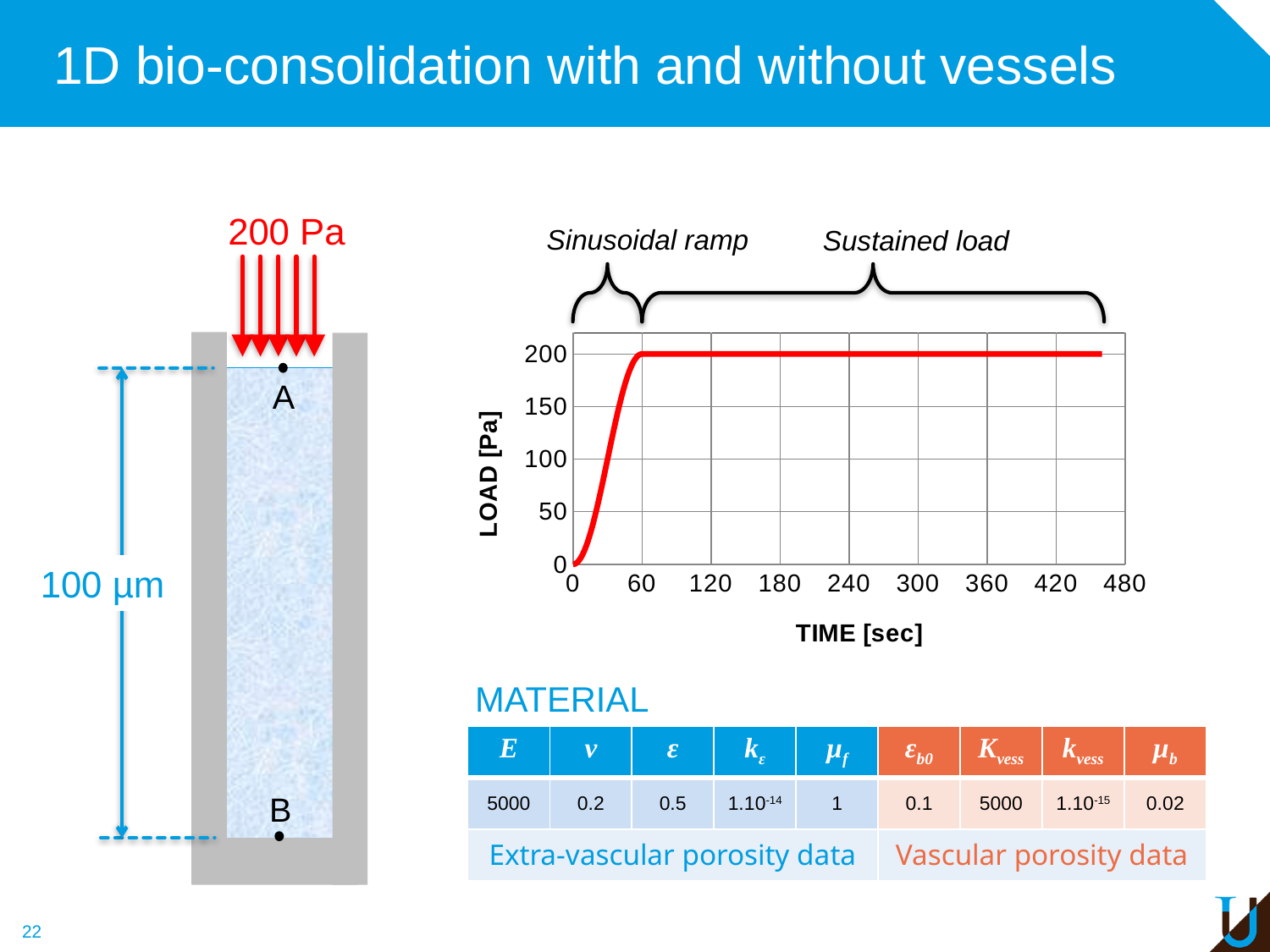
What is the label of the y axis of the chart? LOAD [Pa] What is the label of the x axis of the chart? TIME [sec] Is the load at 10 sec greater or less than 50? less Is the load at 120 sec greater or less than 150? greater What is the minimum load value on the curve? 0 What is the maximum load value reached by the curve? 200 What load value does the curve level off at during the sustained load phase? 200 What kind of chart is shown on the slide? line chart Is the load at 300 sec greater or less than 150? greater How many lines are plotted on the chart? 1 What is the load value at time 0 sec? 0 How does the load change along the time axis? rises from 0 to 200, then stays constant